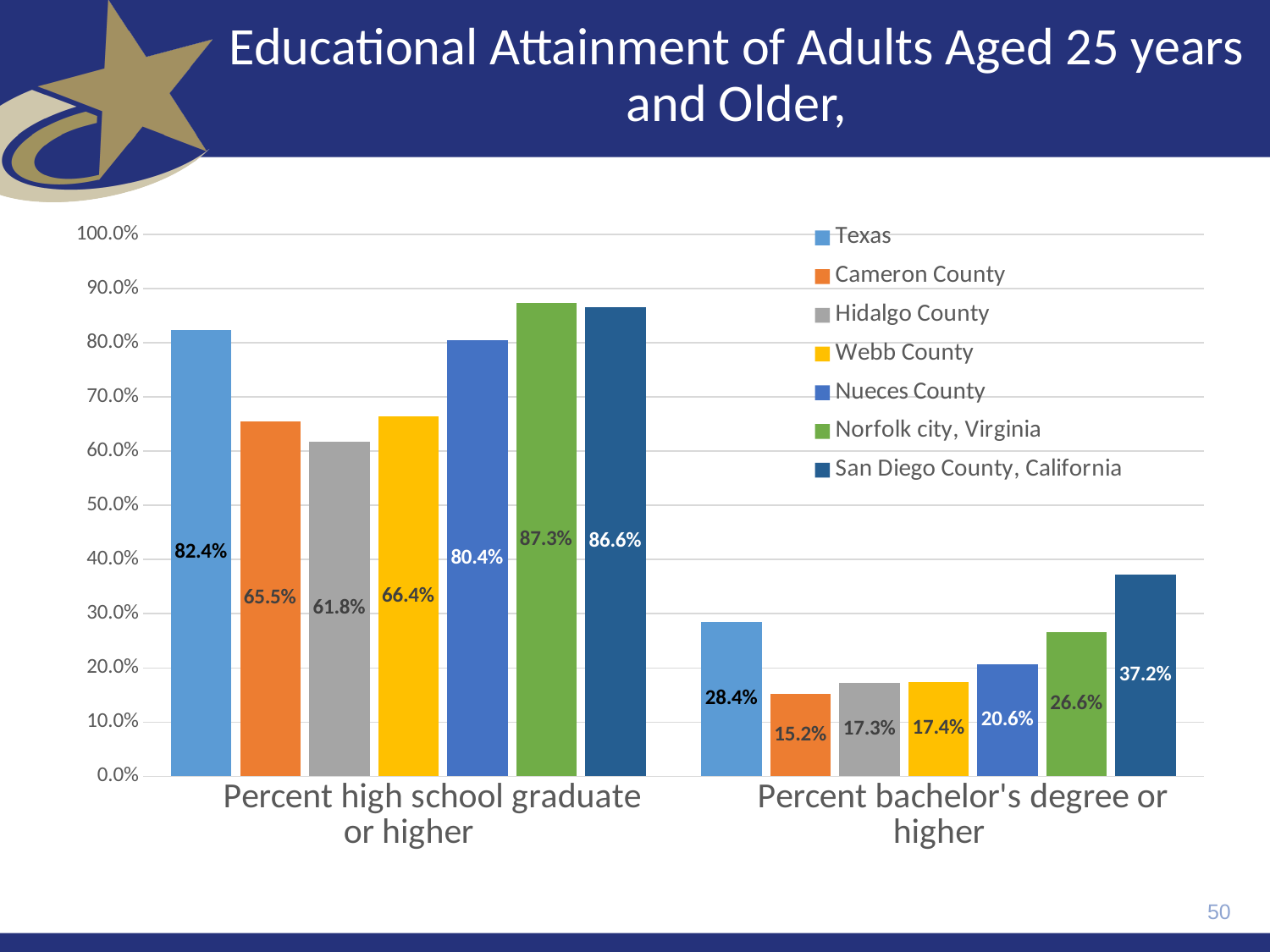
Which series has the lowest value in the 'Percent bachelor's degree or higher' category? Cameron County What kind of chart is shown on the slide? Bar chart How many categories are shown on the x axis? 2 What is the difference between Texas and Cameron County in the 'Percent bachelor's degree or higher' category? 13.2% What colour represents Webb County in the chart? Yellow How many series does the legend list? 7 What is the value for Texas in the 'Percent high school graduate or higher' category? 82.4% Which is larger in the 'Percent high school graduate or higher' category: Webb County or Cameron County? Webb County Is the value for Nueces County in the 'Percent bachelor's degree or higher' category greater or less than 30.0%? less What is the value for Hidalgo County in the 'Percent high school graduate or higher' category? 61.8% What is the value for San Diego County, California in the 'Percent bachelor's degree or higher' category? 37.2% Which series has the highest value in the 'Percent high school graduate or higher' category? Norfolk city, Virginia